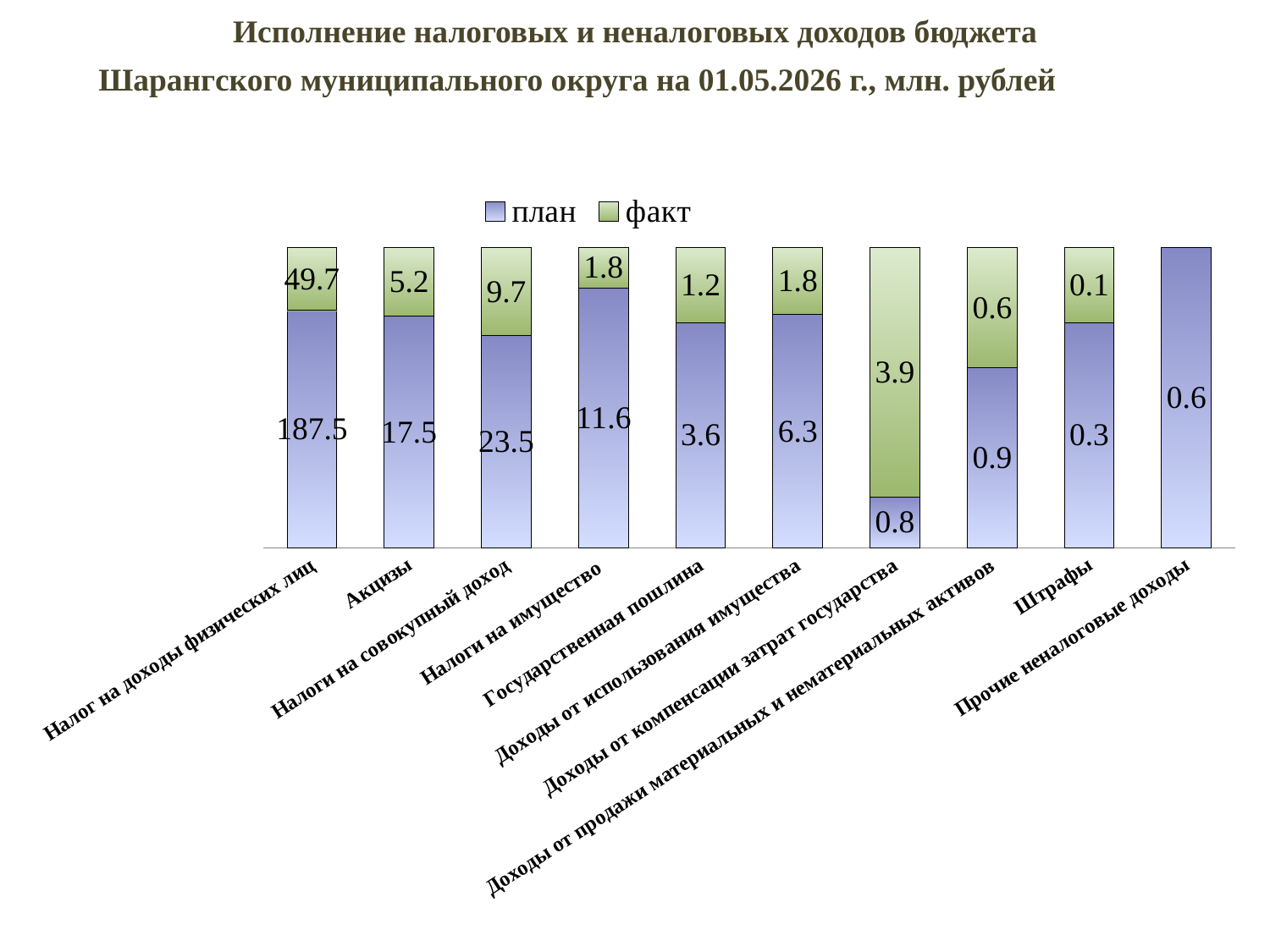
What is the план value for Акцизы? 17.5 What is the факт value for Налоги на совокупный доход? 9.7 How many categories are shown on the x axis? 10 What is the план value for Доходы от компенсации затрат государства? 0.8 What is the факт value for Штрафы? 0.1 What kind of chart is shown on the slide? Stacked bar chart Which category has the lowest план value? Штрафы Which is larger for Доходы от компенсации затрат государства: the план value or the факт value? факт What is the difference between the план and факт values for Налоги на имущество? 9.8 Which category has the highest план value? Налог на доходы физических лиц How many series does the legend list? 2 What is the difference between the план and факт values for Налог на доходы физических лиц? 137.8